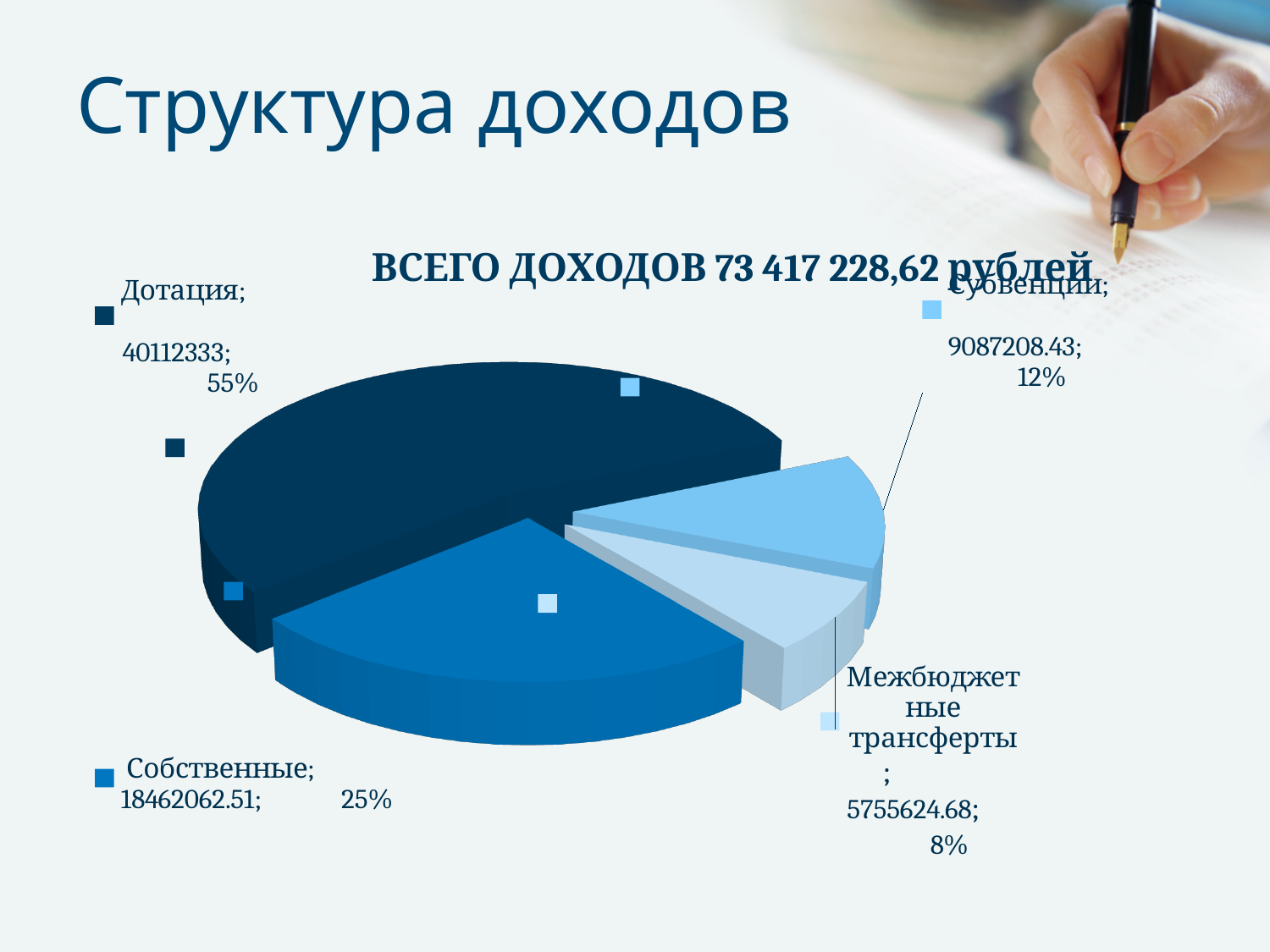
What share of the pie does Собственные represent? 25% What type of chart is shown on the slide? pie chart What is the value shown for Собственные? 18462062.51 How many slices does the pie chart have? 4 What is the value shown for Дотация? 40112333 Which is larger, Субвенции or Собственные? Собственные What share of the pie does Дотация represent? 55% What is the value shown for Межбюджетные трансферты? 5755624.68 What is the value shown for Субвенции? 9087208.43 Which category has the largest slice? Дотация What is the title of the chart? ВСЕГО ДОХОДОВ 73 417 228,62 рублей Which category has the smallest slice? Межбюджетные трансферты